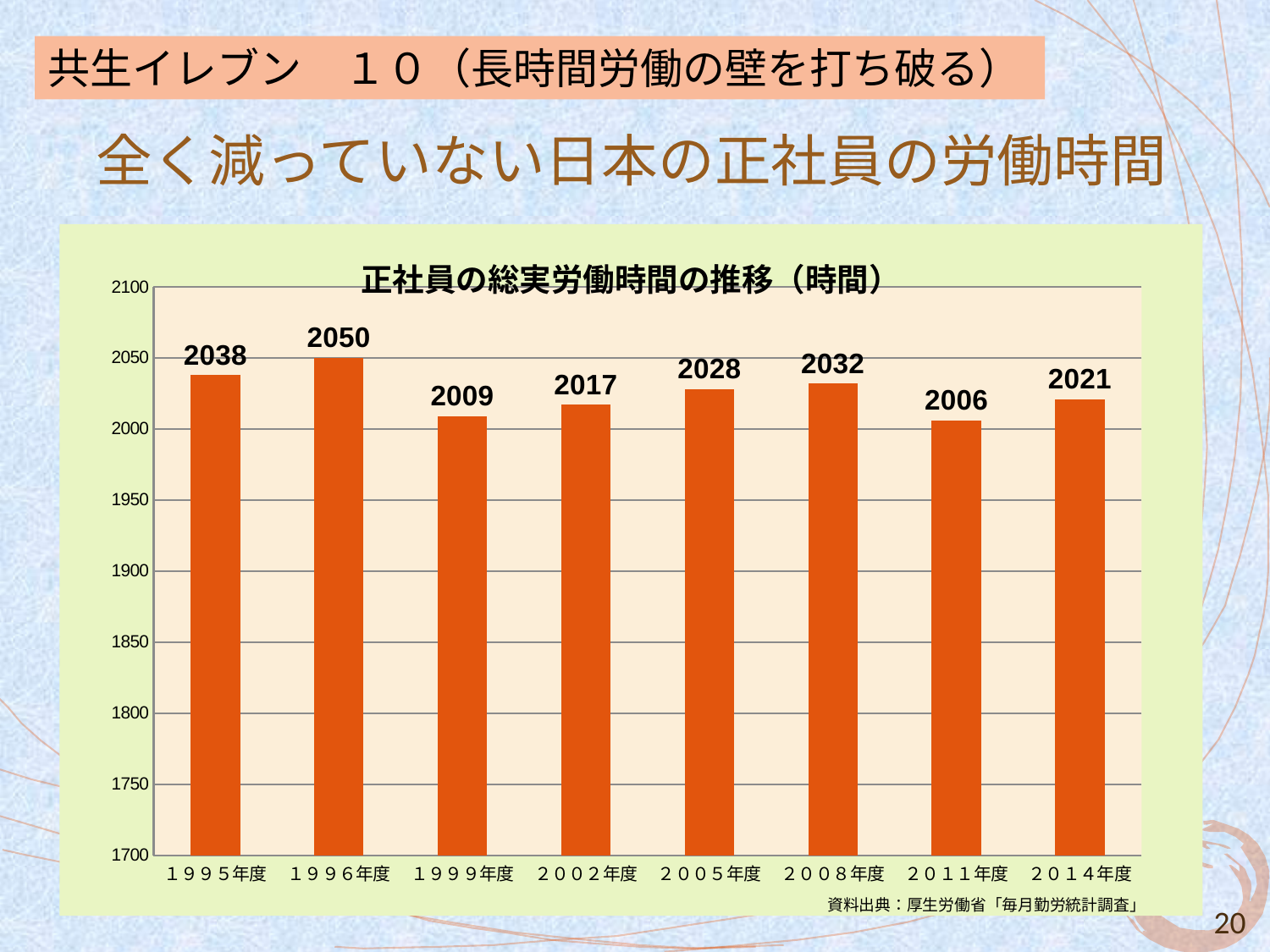
How many years are shown on the x axis? 8 What is the value for 1996年度? 2050 What kind of chart is this? bar chart Which year has the lowest value? 2011年度 What is the value for 2005年度? 2028 What is the value for 2011年度? 2006 What is the title of the chart? 正社員の総実労働時間の推移（時間） Which is larger, the value for 2008年度 or the value for 2002年度? 2008年度 What is the difference between the values for 1995年度 and 2014年度? 17 What is the difference between the values for 1996年度 and 2011年度? 44 Is the value for 1999年度 greater or less than 2000? greater Which year has the highest value? 1996年度